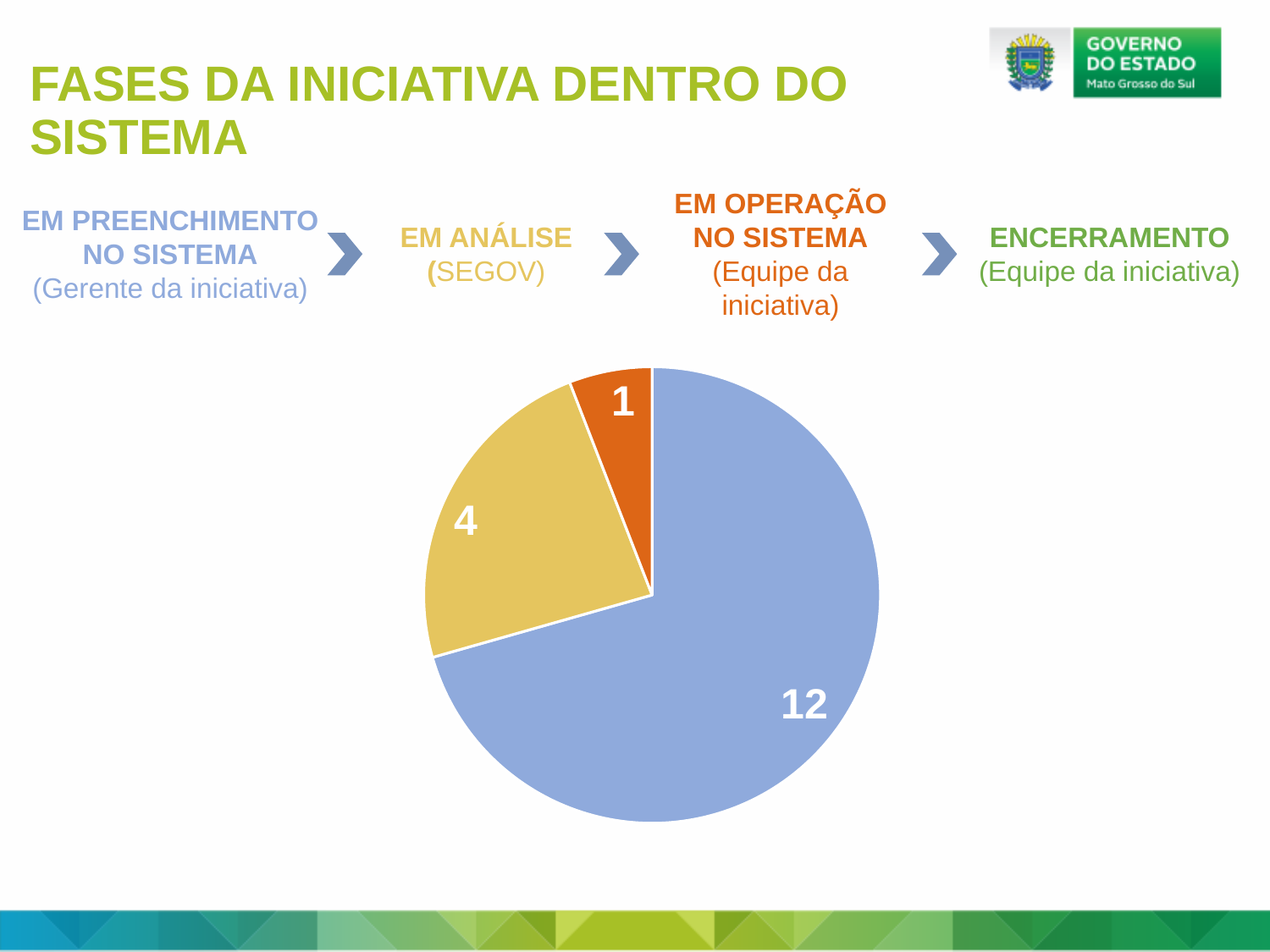
What value is shown on the blue slice of the pie chart? 12 What is the title of the slide containing the pie chart? FASES DA INICIATIVA DENTRO DO SISTEMA What value is shown on the yellow slice of the pie chart? 4 What is the difference between the yellow slice and the orange slice in the pie chart? 3 Which slice of the pie chart has the smallest value? the orange slice (1) How many slices does the pie chart have? 3 Which slice of the pie chart has the largest value? the blue slice (12) What is the difference between the blue slice and the yellow slice in the pie chart? 8 Which is larger in the pie chart, the yellow slice or the orange slice? the yellow slice What is the total of all the values shown in the pie chart? 17 What value is shown on the orange slice of the pie chart? 1 What kind of chart is shown on the slide? pie chart